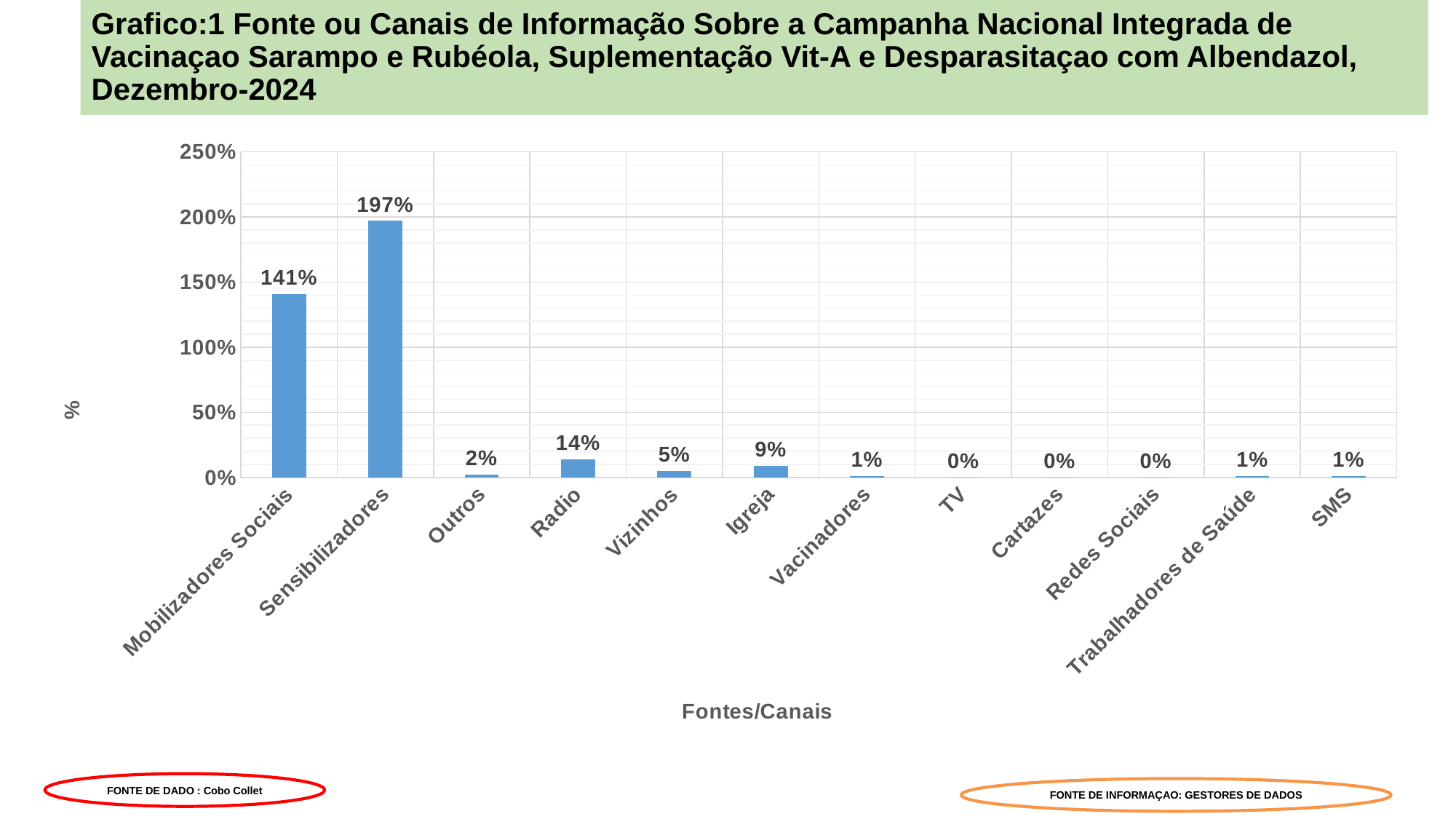
What is the difference between the values for Sensibilizadores and Mobilizadores Sociais? 56% What is the value for Radio? 14% What is the value for Outros? 2% Which category has the highest value? Sensibilizadores How many categories are shown on the x axis? 12 What is the label of the x axis? Fontes/Canais What is the value for Igreja? 9% What is the value for Sensibilizadores? 197% What is the value for Mobilizadores Sociais? 141% What kind of chart is shown on the slide? bar chart Is the value for Mobilizadores Sociais greater or less than 100%? greater Which is larger, the value for Radio or the value for Vizinhos? Radio